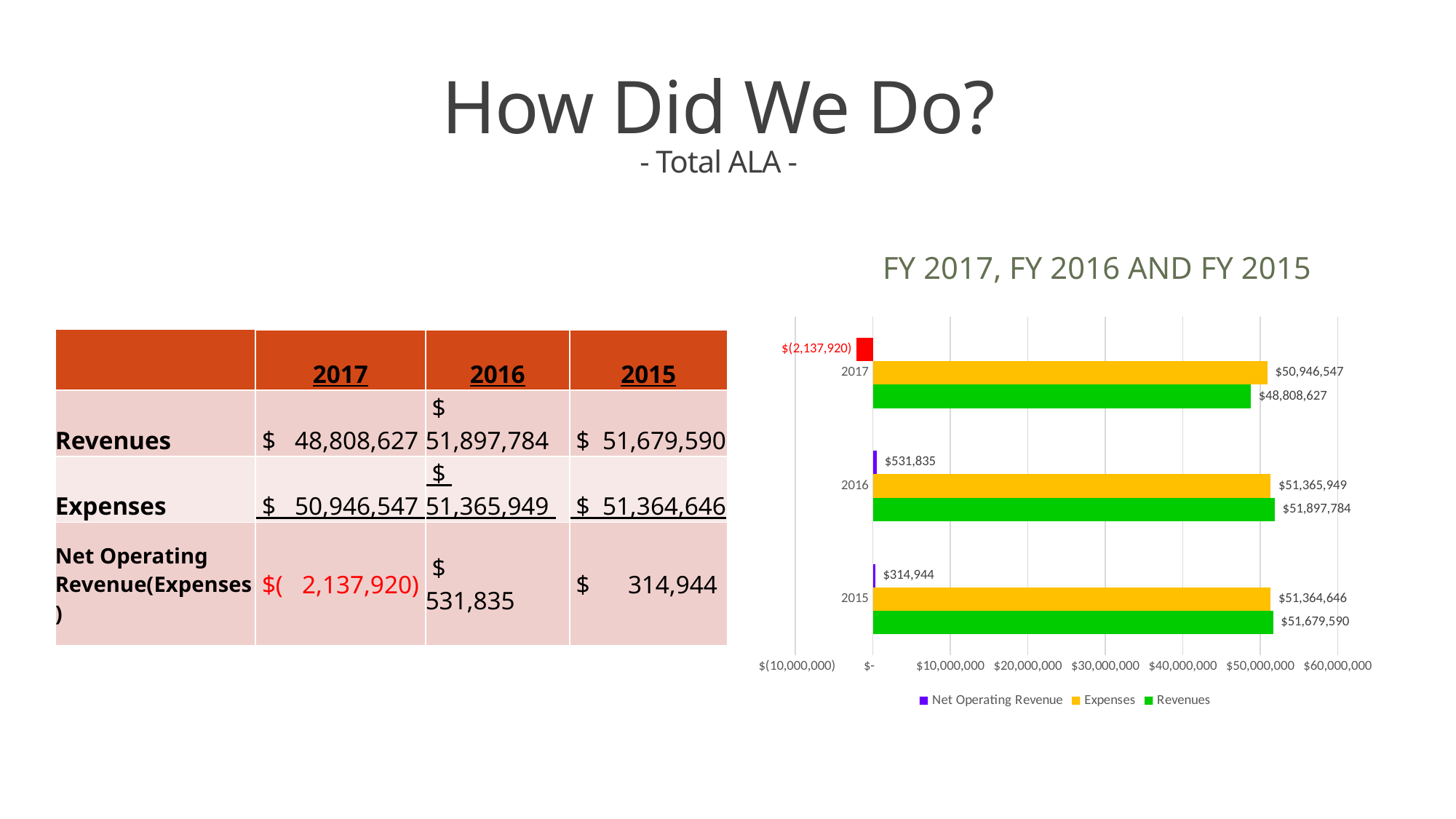
Which year has the lowest Revenues in the chart? 2017 What is the Expenses value for 2016 in the chart? $51,365,949 What is the Net Operating Revenue value for 2017 in the chart? $(2,137,920) What is the Net Operating Revenue value for 2015 in the chart? $314,944 What is the title of the chart? FY 2017, FY 2016 AND FY 2015 How many series does the chart legend list? 3 What is the Revenues value for 2017 in the chart? $48,808,627 Is the Revenues value for 2016 larger or smaller than the Expenses value for 2016? larger What is the difference between Expenses and Revenues for 2017 in the chart? $2,137,920 Which year has the highest Revenues in the chart? 2016 Which year has the lowest Net Operating Revenue in the chart? 2017 What kind of chart is shown on the slide? bar chart